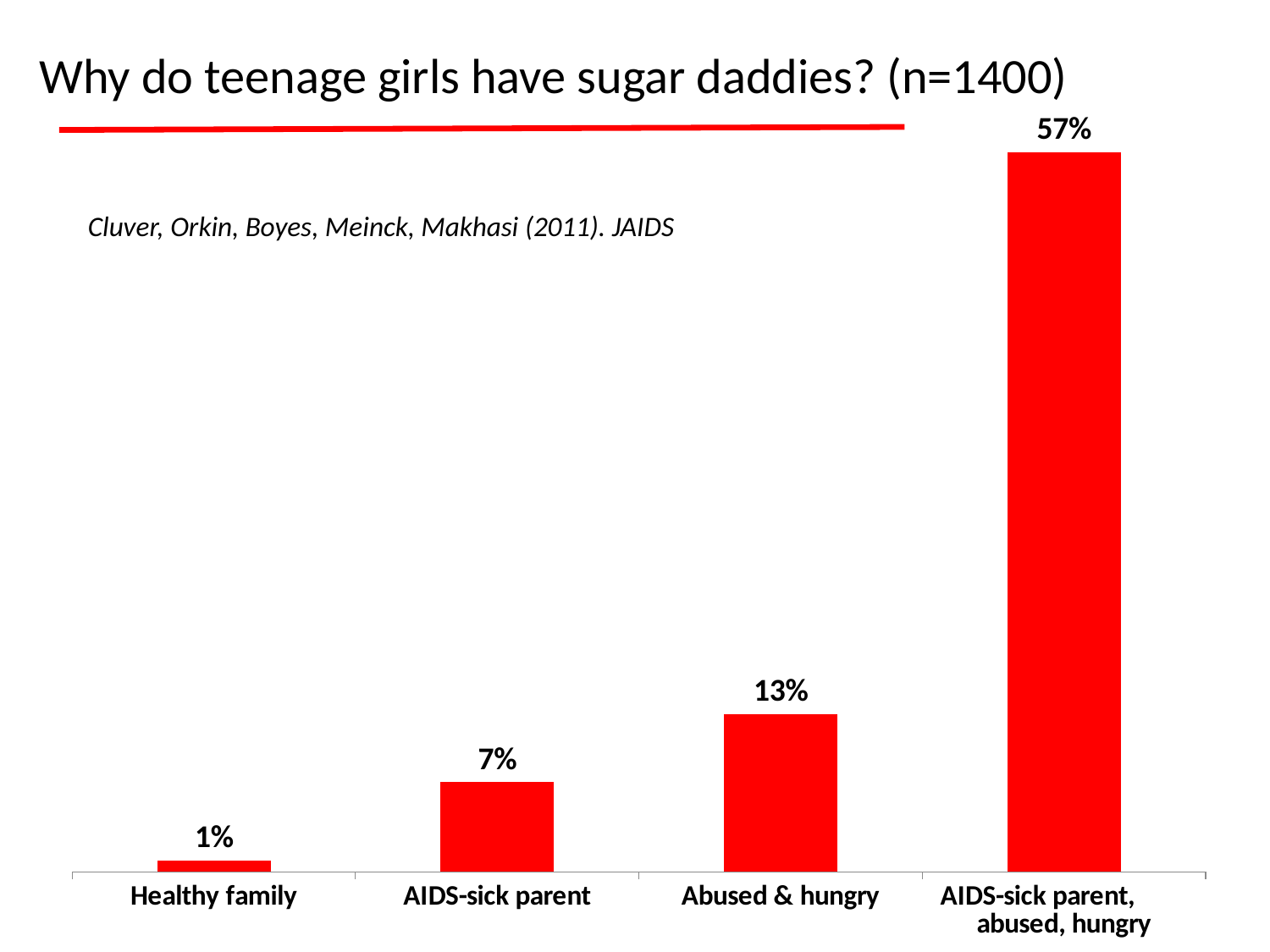
What is the difference between the values for Abused & hungry and AIDS-sick parent? 6% Which category has the lowest value? Healthy family Which category has the highest value? AIDS-sick parent, abused, hungry How many categories are shown on the x axis? 4 What is the value for AIDS-sick parent? 7% What kind of chart is shown on the slide? Bar chart Do the values rise or fall from left to right along the x axis? Rise What is the value for Healthy family? 1% What is the difference between the values for AIDS-sick parent, abused, hungry and Abused & hungry? 44% Which is larger, the value for AIDS-sick parent or the value for Abused & hungry? Abused & hungry What is the value for AIDS-sick parent, abused, hungry? 57% What is the value for Abused & hungry? 13%